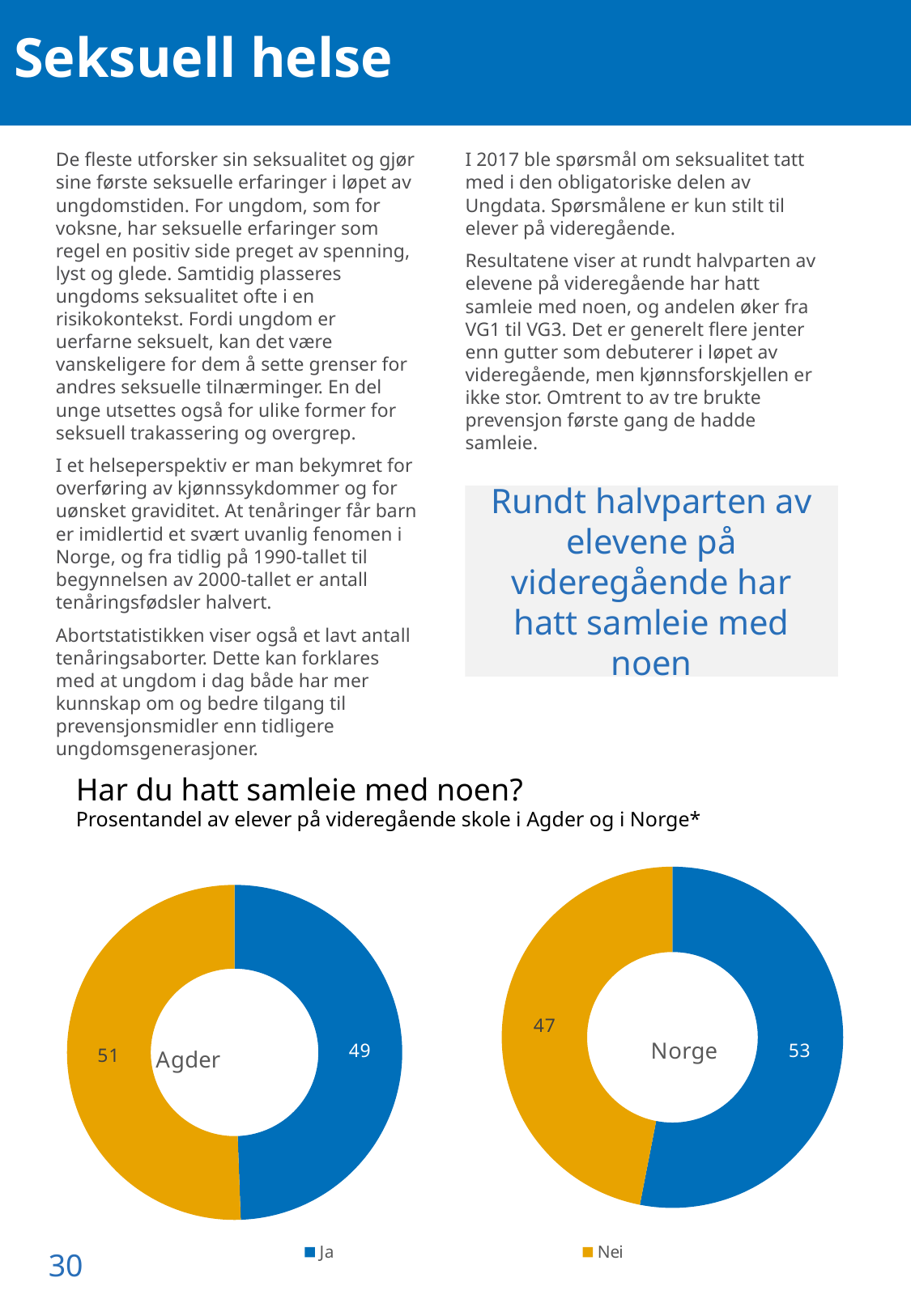
What is the title of the chart section on the slide? Har du hatt samleie med noen? What type of chart is used to show the Agder and Norge data? Doughnut (pie) chart In the Norge doughnut chart, what is the value for Nei? 47 In the Norge doughnut chart, which category has the larger share, Ja or Nei? Ja In the Norge doughnut chart, what is the difference between the Ja and Nei values? 6 How many categories does the legend list for the doughnut charts? 2 Which colour represents Nei in the doughnut charts? Orange In the Norge doughnut chart, what is the value for Ja? 53 What is the difference between the Ja value in the Norge chart and the Ja value in the Agder chart? 4 In the Agder doughnut chart, what is the value for Ja? 49 In the Agder doughnut chart, which category has the larger share, Ja or Nei? Nei In the Agder doughnut chart, what is the value for Nei? 51